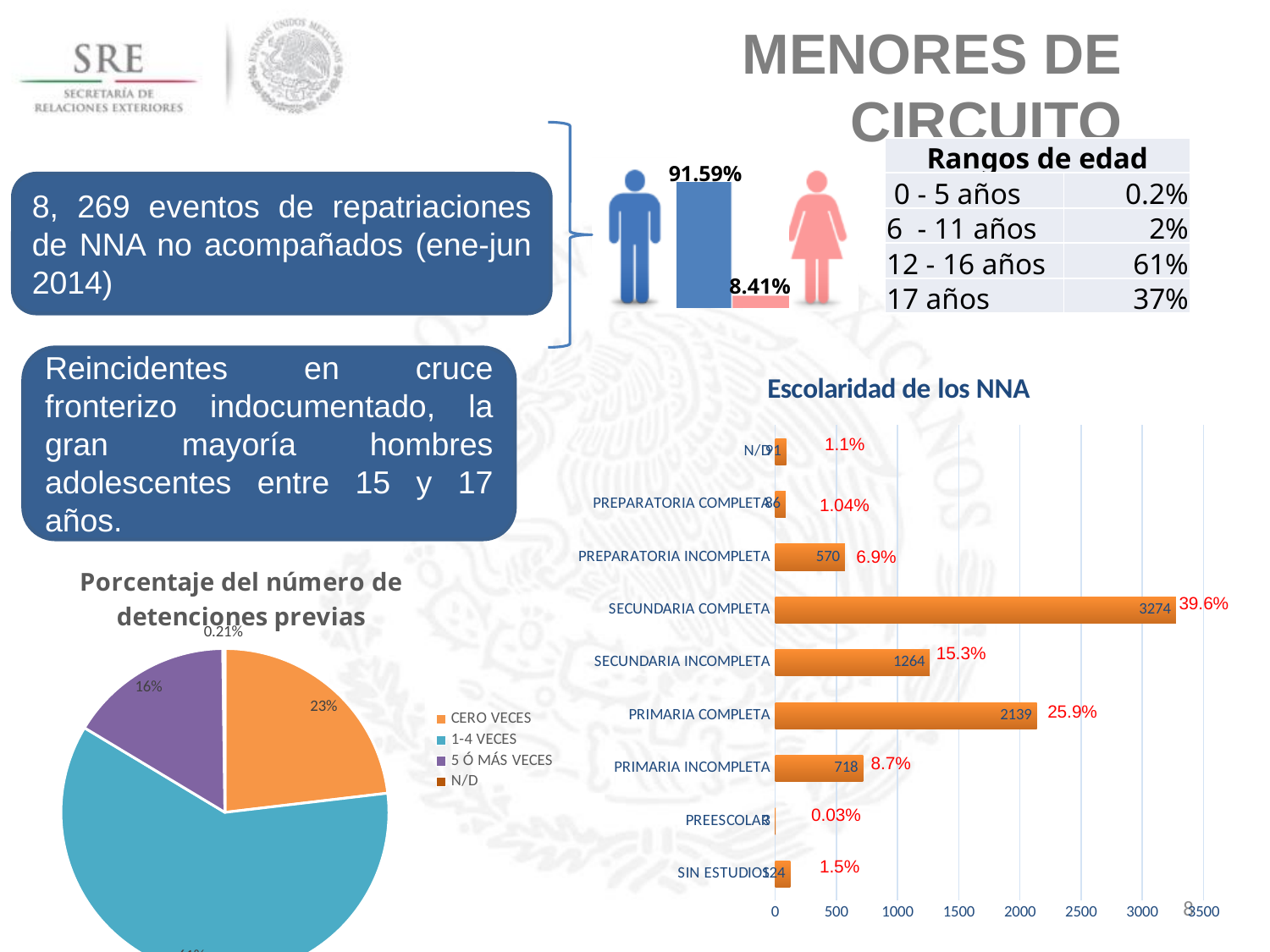
In the 'Escolaridad de los NNA' chart, which is larger: PREPARATORIA INCOMPLETA or PRIMARIA INCOMPLETA? PRIMARIA INCOMPLETA In the 'Escolaridad de los NNA' chart, is the value for SECUNDARIA INCOMPLETA greater or less than 1000? greater In the 'Escolaridad de los NNA' chart, what is the difference between the values for SECUNDARIA COMPLETA and PRIMARIA COMPLETA? 1135 In the 'Escolaridad de los NNA' chart, what is the value for SECUNDARIA COMPLETA? 3274 How many entries does the legend of the pie chart 'Porcentaje del número de detenciones previas' list? 4 In the 'Escolaridad de los NNA' chart, which category has the highest value? SECUNDARIA COMPLETA How many categories are shown in the 'Escolaridad de los NNA' chart? 9 In the gender bar chart at the top of the slide, what is the difference between the male and female percentages? 83.18% In the 'Escolaridad de los NNA' chart, what percentage is shown for PRIMARIA COMPLETA? 25.9% What kind of chart is 'Escolaridad de los NNA'? bar chart In the pie chart 'Porcentaje del número de detenciones previas', what share does CERO VECES have? 23% In the 'Escolaridad de los NNA' chart, which category has the lowest value? PREESCOLAR